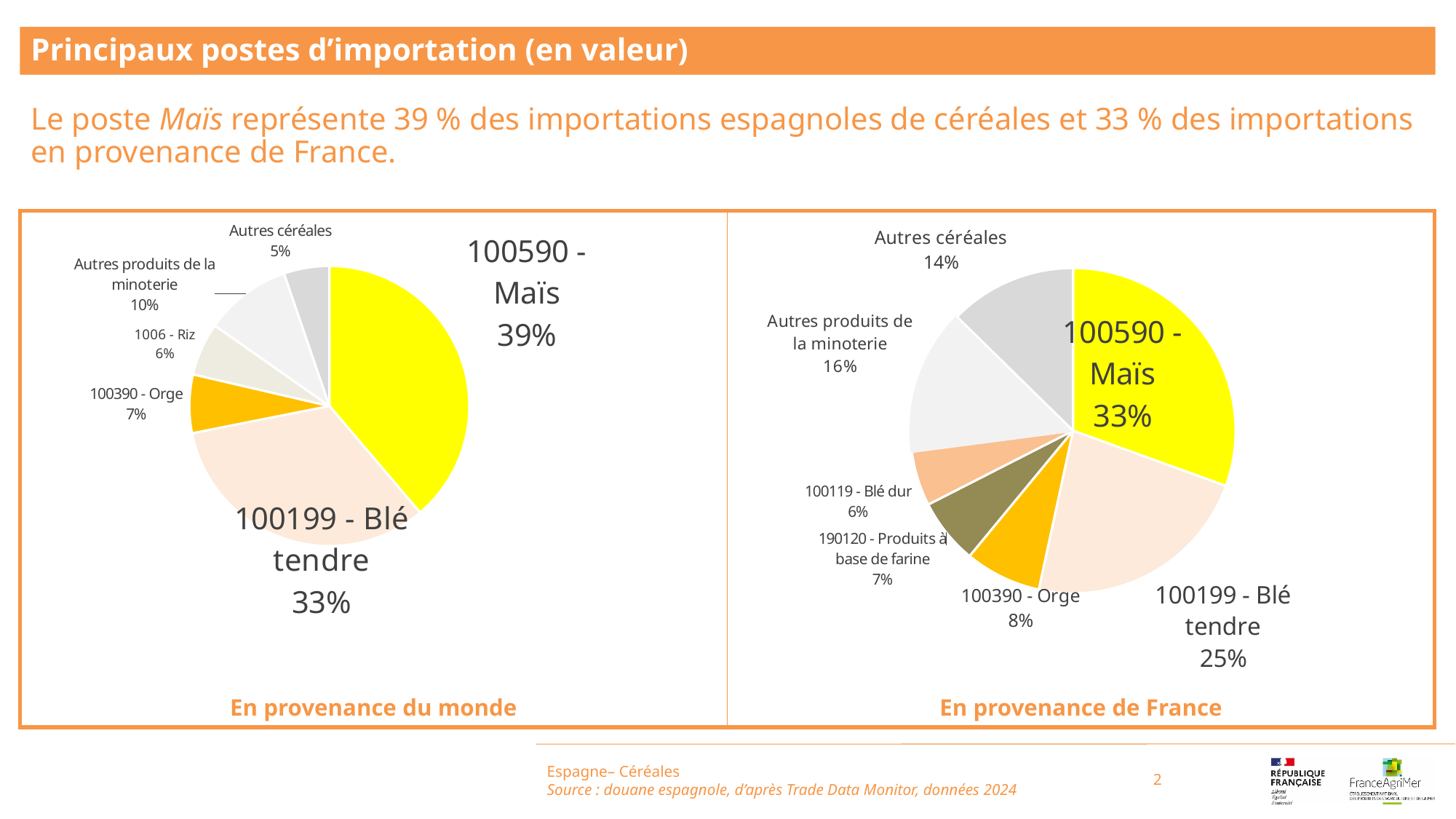
How many slices does the 'En provenance du monde' pie chart have? 6 In the 'En provenance de France' pie chart, what is the share of Autres produits de la minoterie? 16% How many slices does the 'En provenance de France' pie chart have? 7 In the 'En provenance de France' pie chart, what share does 100199 - Blé tendre have? 25% In the 'En provenance de France' pie chart, which category has the smallest share? 100119 - Blé dur What type of chart is used for 'En provenance de France'? Pie chart In the 'En provenance du monde' pie chart, which is larger: the share of 100390 - Orge or the share of Autres produits de la minoterie? Autres produits de la minoterie In the 'En provenance de France' pie chart, what is the difference between the shares of 100590 - Maïs and 100199 - Blé tendre? 8% In the 'En provenance du monde' pie chart, which category has the largest share? 100590 - Maïs In the 'En provenance du monde' pie chart, what is the share of 1006 - Riz? 6% In the 'En provenance du monde' pie chart, what share does 100590 - Maïs have? 39% In the 'En provenance du monde' pie chart, which category has the smallest share? Autres céréales